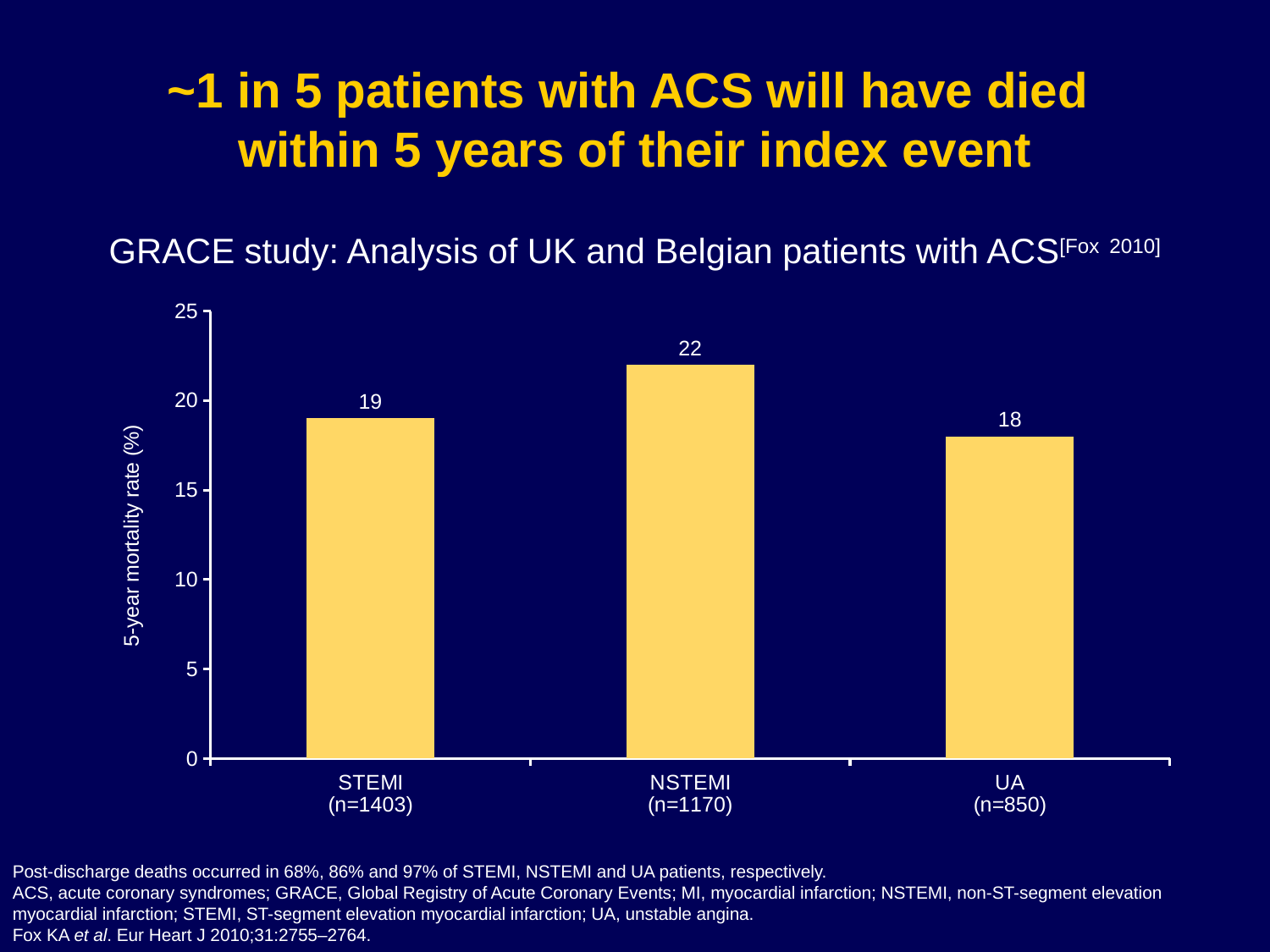
What is the difference in 5-year mortality rate between NSTEMI and UA patients? 4 What is the 5-year mortality rate for NSTEMI patients? 22 Is the 5-year mortality rate for NSTEMI greater or less than 20? greater Which patient group has the highest 5-year mortality rate? NSTEMI What is the label of the y axis? 5-year mortality rate (%) What kind of chart is shown on the slide? Bar chart Which patient group has the lowest 5-year mortality rate? UA Which has a higher 5-year mortality rate, STEMI or UA? STEMI What is the 5-year mortality rate for STEMI patients? 19 What is the 5-year mortality rate for UA patients? 18 What is the difference in 5-year mortality rate between NSTEMI and STEMI patients? 3 How many patient groups are shown in the chart? 3